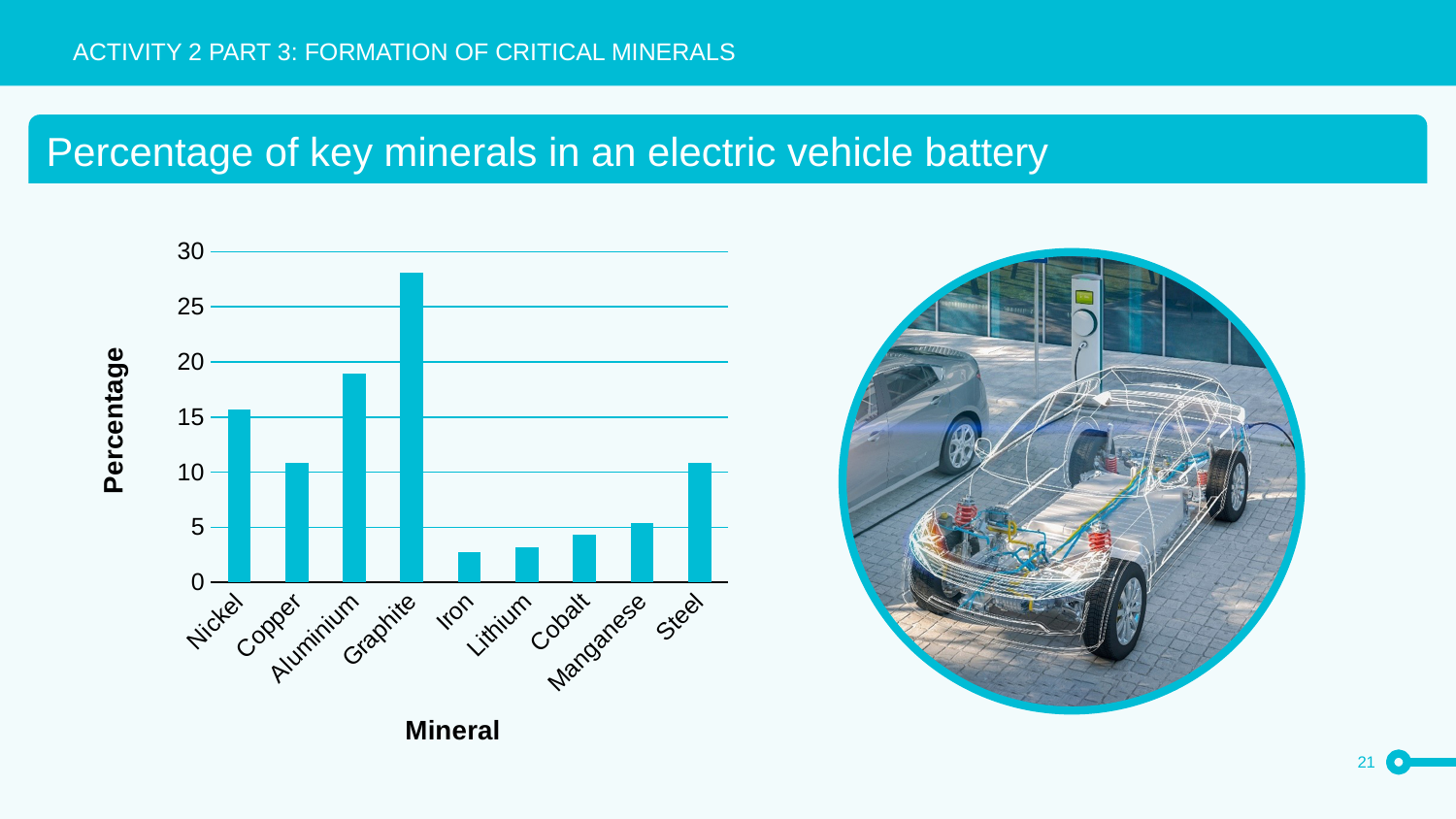
Which mineral has the highest percentage in the chart? Graphite Which has a higher percentage, Aluminium or Nickel? Aluminium What kind of chart is shown on the slide? bar chart Is the value for Aluminium greater or less than 20? less What is the title of the chart's y axis? Percentage Is the value for Graphite greater or less than 25? greater How many minerals are shown on the x axis of the chart? 9 Is the value for Nickel greater or less than 15? greater What is the title of the chart's x axis? Mineral Which has a higher percentage, Nickel or Copper? Nickel